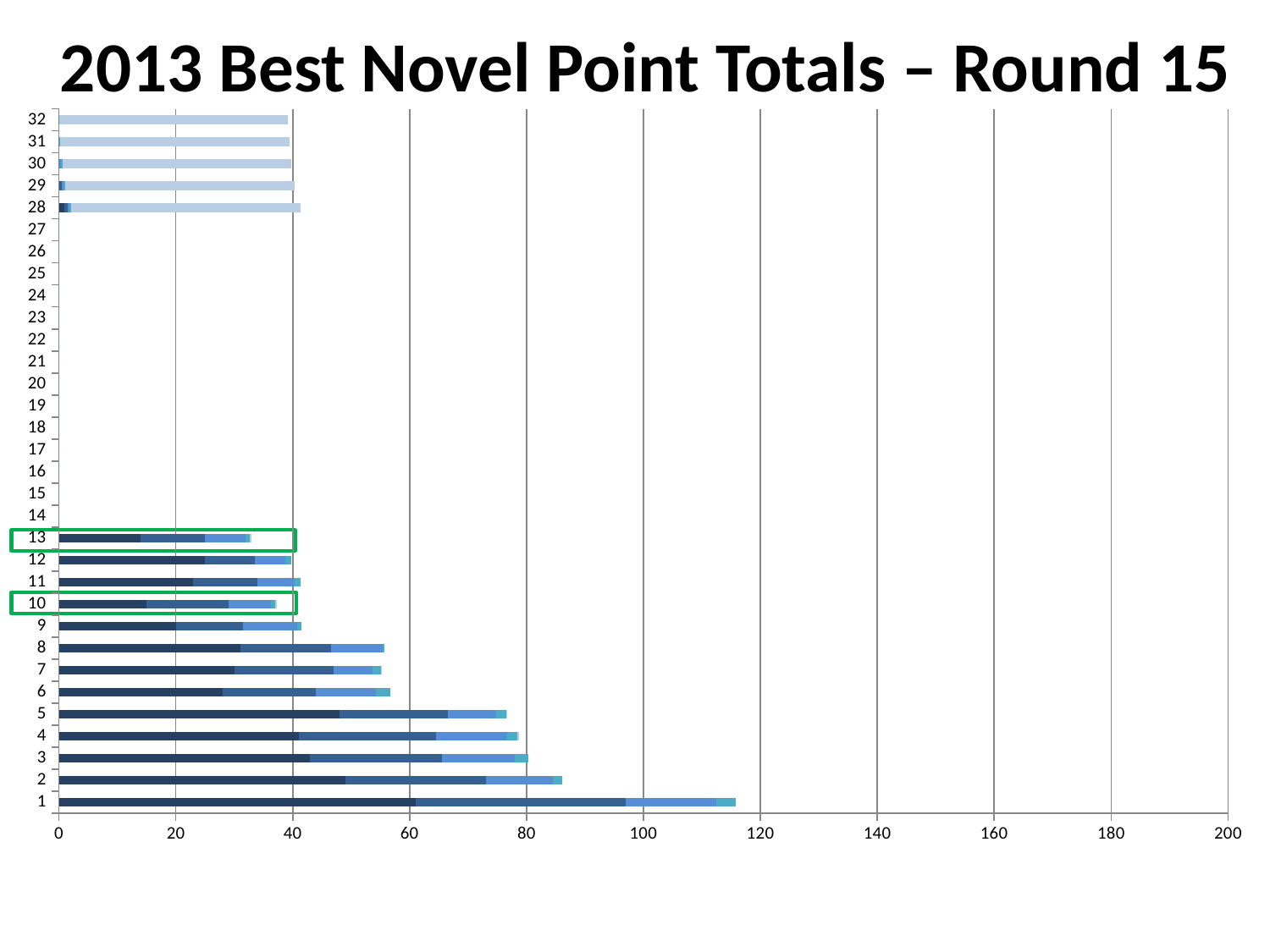
Which category has the longest bar in the chart? 1 Is the total bar length for category 13 greater or less than 40? less Which two categories are outlined with green boxes on the chart? 10 and 13 What is the title of the chart? 2013 Best Novel Point Totals – Round 15 How many categories are listed on the vertical axis of the chart? 32 Is the total bar length for category 2 greater or less than 80? greater Going from category 1 up to category 13, do the bars generally get longer or shorter? shorter What kind of chart is shown on the slide? Bar chart Is the total bar length for category 8 greater or less than 60? less Which has the longer bar, category 8 or category 13? 8 Which has the longer bar, category 1 or category 2? 1